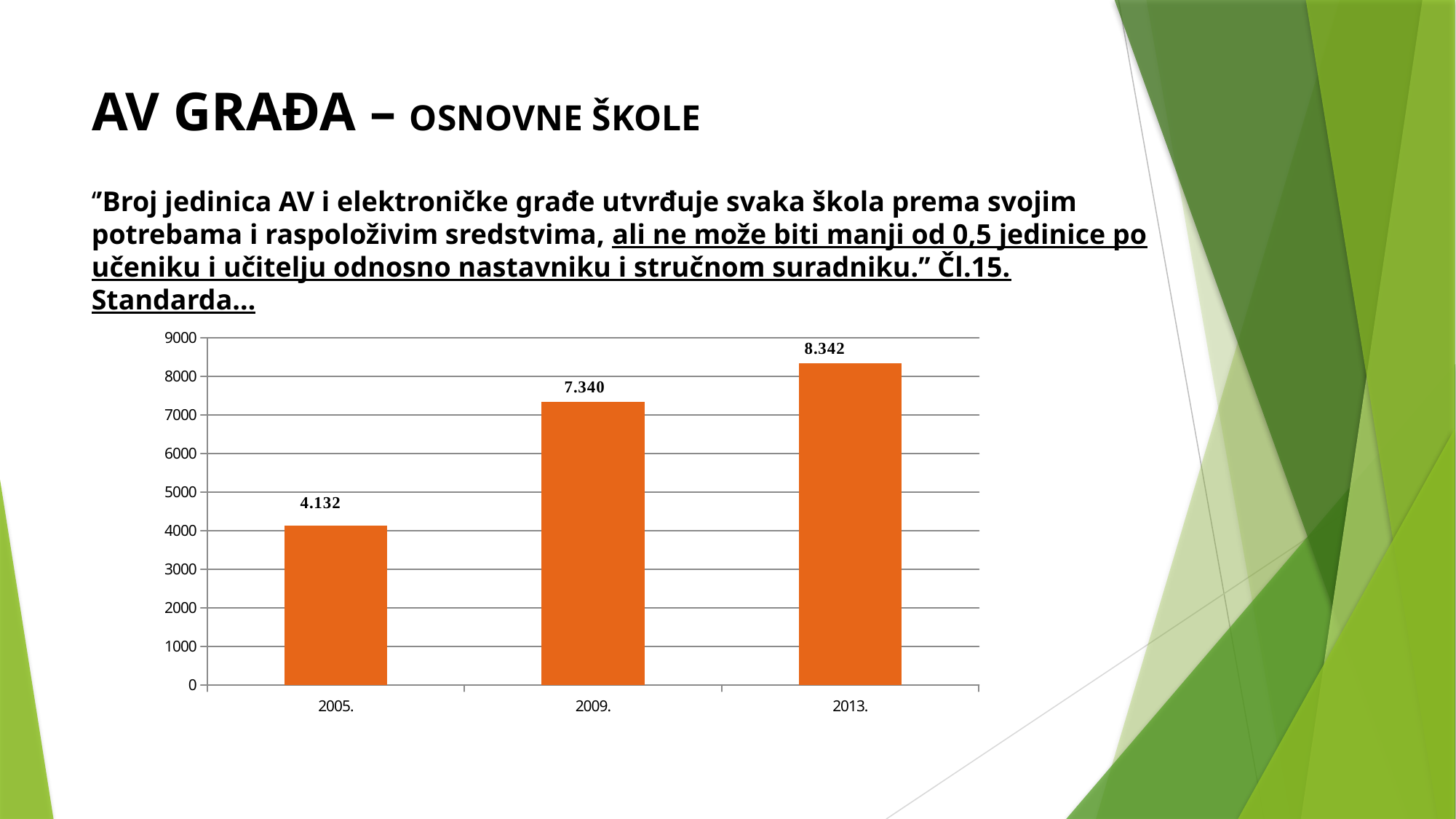
What kind of chart is shown on the slide? bar chart How many bars are shown in the chart? 3 Which is larger, the value for 2005. or the value for 2009.? 2009. What is the value for 2009.? 7.340 Is the value for 2013. greater or less than 8000? greater What is the value for 2005.? 4.132 Do the values rise or fall from 2005. to 2013.? rise Which year has the highest value? 2013. Which year has the lowest value? 2005. What is the difference between the values for 2013. and 2009.? 1.002 What is the difference between the values for 2009. and 2005.? 3.208 What is the value for 2013.? 8.342